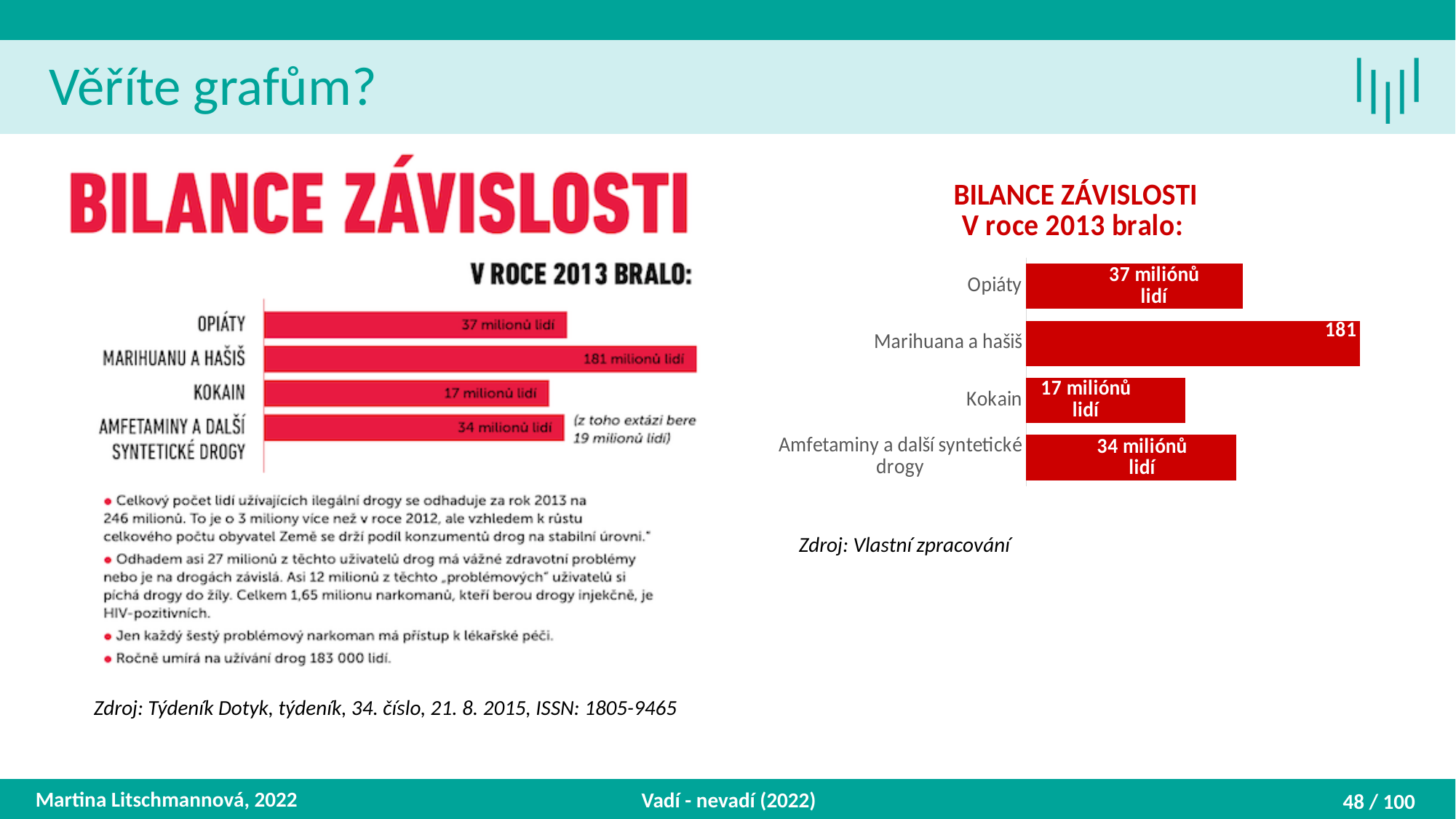
What is the source given below the right-hand chart? Zdroj: Vlastní zpracování In the left-hand infographic chart, what value is shown for Marihuanu a hašiš? 181 milionů lidí In the right-hand chart (BILANCE ZÁVISLOSTI, V roce 2013 bralo), what is the data label on the bar for Opiáty? 37 miliónů lidí In the right-hand chart, what is the data label on the bar for Marihuana a hašiš? 181 In the right-hand chart, which category has the shortest bar? Kokain In the right-hand chart, is the value for Opiáty larger or smaller than the value for Amfetaminy a další syntetické drogy? Larger In the right-hand chart, which category has the longest bar? Marihuana a hašiš In the right-hand chart, how many categories are plotted? 4 In the right-hand chart, what is the data label on the bar for Amfetaminy a další syntetické drogy? 34 miliónů lidí In the right-hand chart, what is the data label on the bar for Kokain? 17 miliónů lidí What type of chart is the right-hand chart titled BILANCE ZÁVISLOSTI? Bar chart In the left-hand infographic chart (BILANCE ZÁVISLOSTI), what value is shown for Kokain? 17 milionů lidí